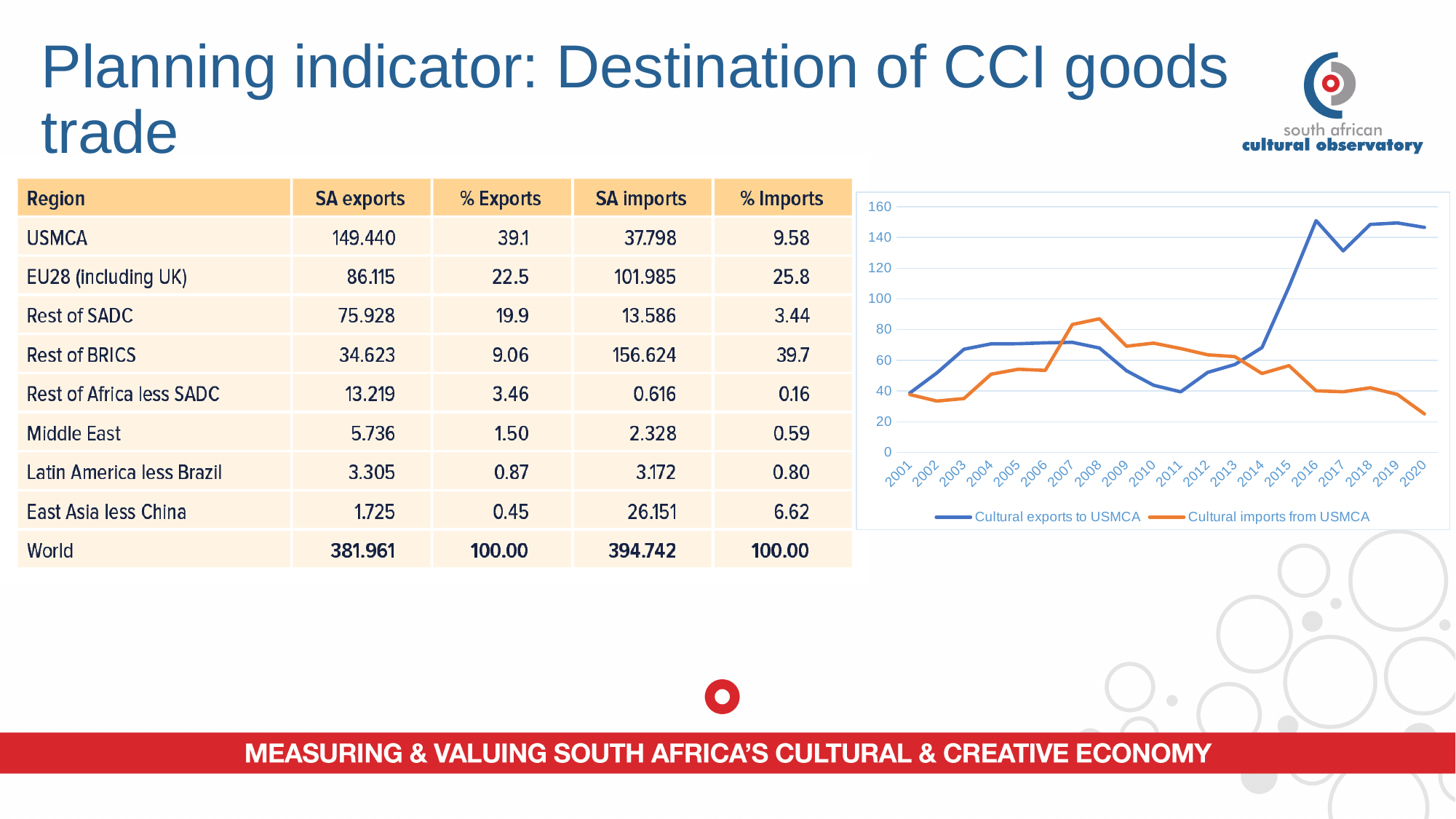
In the line chart, is the value for Cultural imports from USMCA in 2020 greater or less than 40? less In the line chart, is the value for Cultural imports from USMCA in 2008 greater or less than 80? greater What kind of chart is shown on the right of the slide? line chart In the line chart, is the value for Cultural exports to USMCA in 2011 greater or less than 60? less In the line chart, in which year is Cultural imports from USMCA at its lowest? 2020 In the line chart, which series has the higher value in 2008, Cultural exports to USMCA or Cultural imports from USMCA? Cultural imports from USMCA In the line chart, which series has the higher value in 2018, Cultural exports to USMCA or Cultural imports from USMCA? Cultural exports to USMCA How many series does the legend of the line chart list? 2 In the line chart, do the values for Cultural imports from USMCA rise or fall between 2008 and 2020? fall How many years are plotted along the x axis of the line chart? 20 In the line chart, what colour is the line for Cultural exports to USMCA? blue